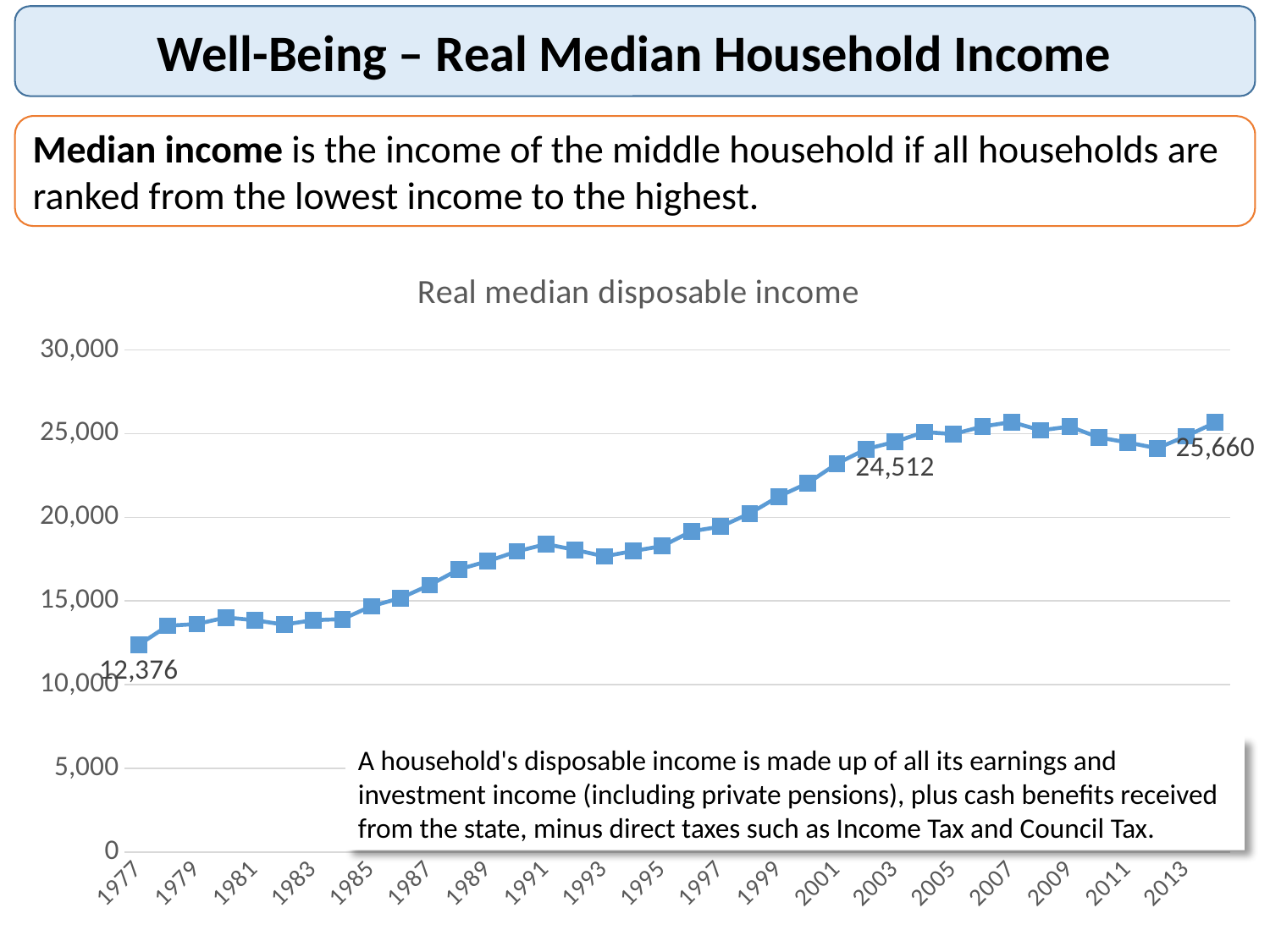
Is the value for 2007 greater or less than 25,000? greater Overall, do the values rise or fall from 1977 to the end of the series? rise What is the difference between the last labelled value (25,660) and the first labelled value (12,376)? 13,284 What is the highest value shown on the vertical axis? 30,000 What is the value of the last data point on the chart? 25,660 Which year has the lowest real median disposable income on the chart? 1977 Is the value for 2001 greater or less than 20,000? greater What is the value of the first data point (1977) on the chart? 12,376 Is the value for 1997 greater or less than 20,000? less What is the title of the chart? Real median disposable income What kind of chart is shown on the slide? line chart